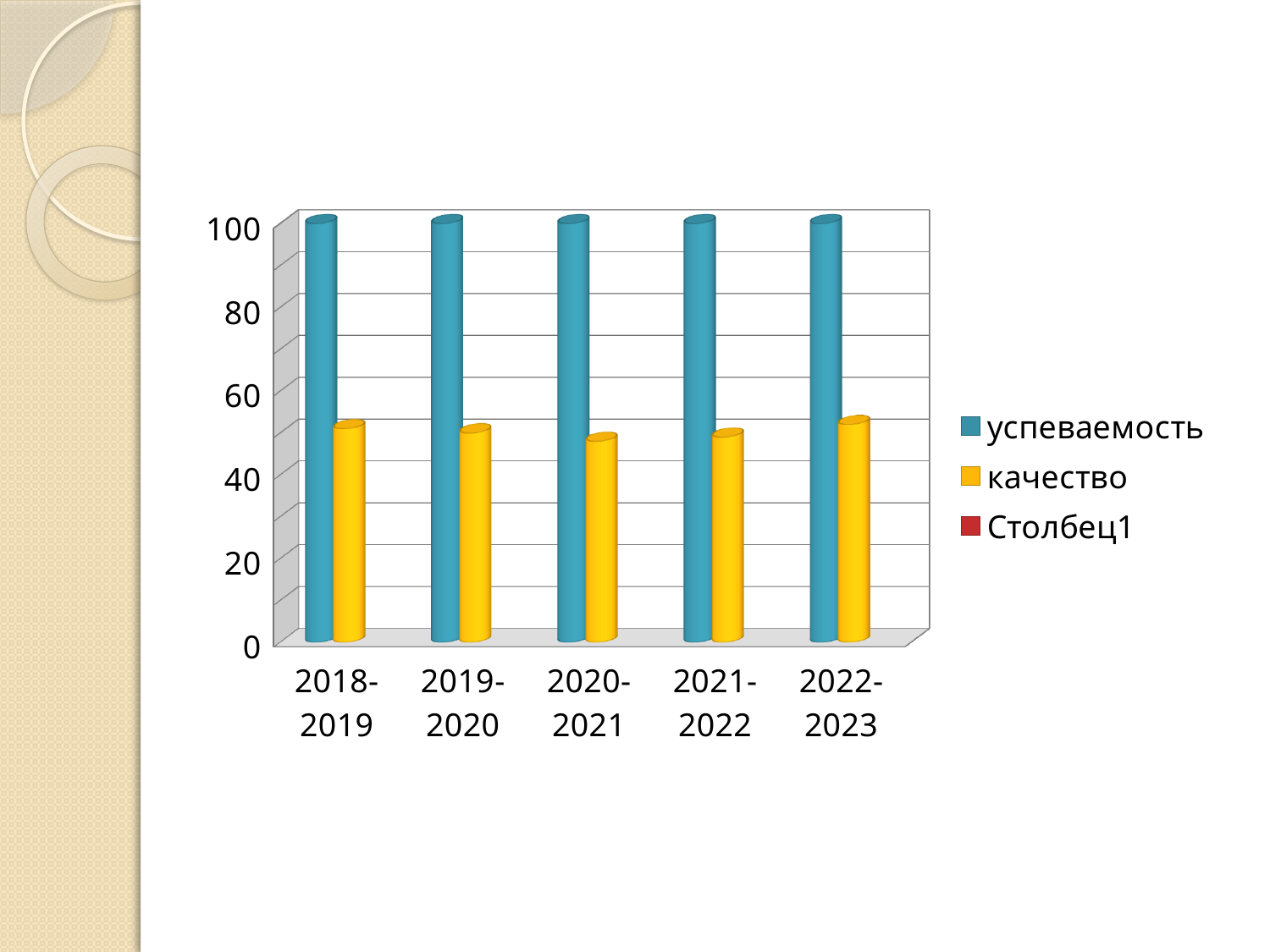
What is the value of успеваемость for 2022-2023? 100 How many series does the legend list? 3 Is the value of качество for 2020-2021 greater or less than 60? less Does the value of успеваемость rise, fall or stay the same across the years? stays the same Is the value of качество for 2018-2019 greater or less than 80? less What is the name of the third series in the legend? Столбец1 What kind of chart is shown on the slide? bar chart Is the value of качество for 2022-2023 greater or less than 40? greater Which series is shown in yellow? качество Which is larger for 2019-2020: успеваемость or качество? успеваемость What is the value of успеваемость for 2018-2019? 100 How many categories (school years) are shown on the x axis? 5